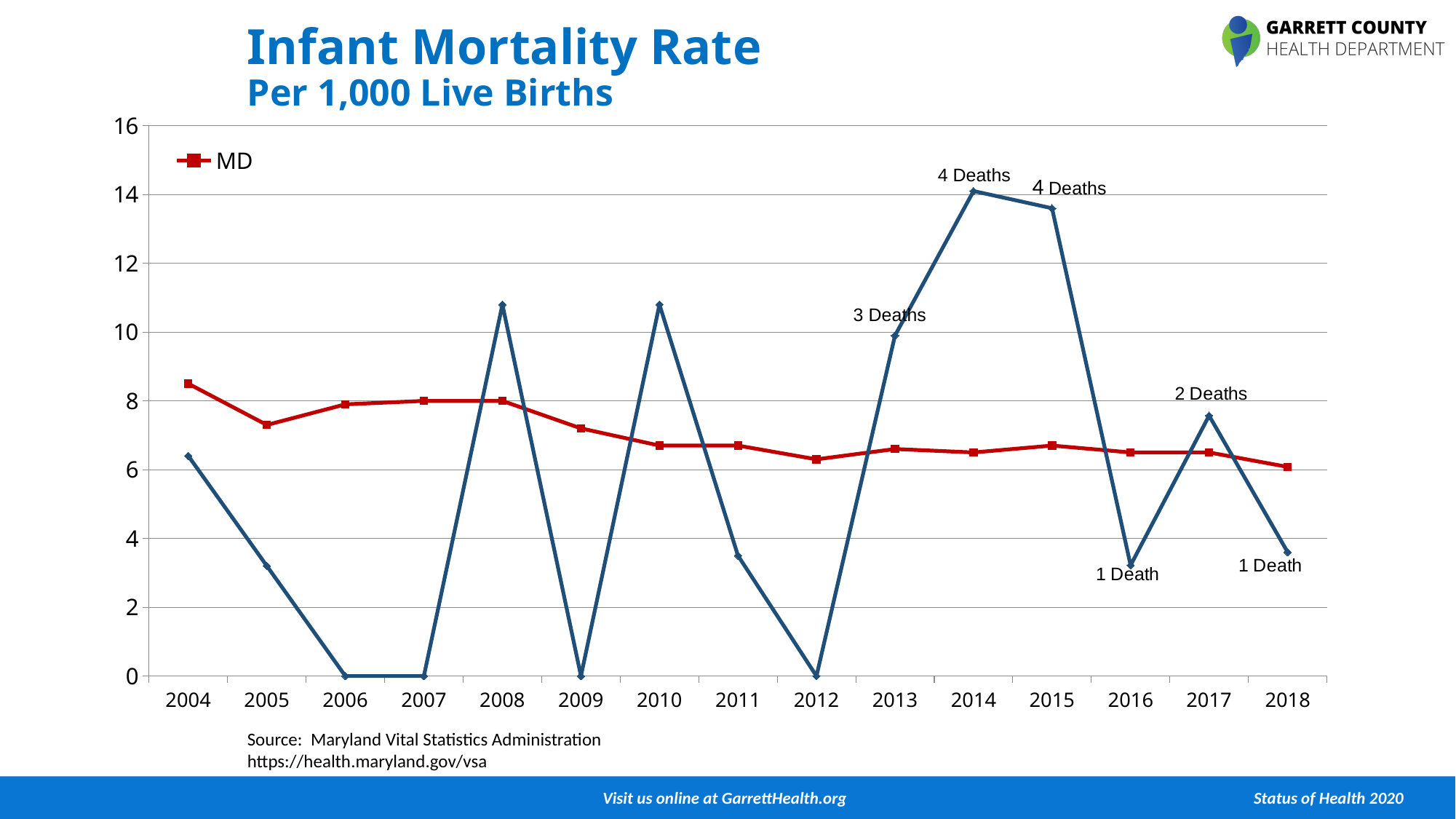
Does the MD line generally rise or fall from 2004 to 2018? fall What is the value of the blue line in 2012? 0 Is the value of the blue line in 2014 greater or less than 12? greater Is the MD value for 2004 greater or less than 8? greater How many series does the legend list? 1 In how many years does the blue line sit at 0? 4 What is the value of the blue line in 2006? 0 In which year is the MD line at its highest? 2004 Is the MD value for 2018 greater or less than 8? less How many years are plotted along the x axis? 15 In which year does the blue line reach its highest value? 2014 What kind of chart is shown on the slide? line chart